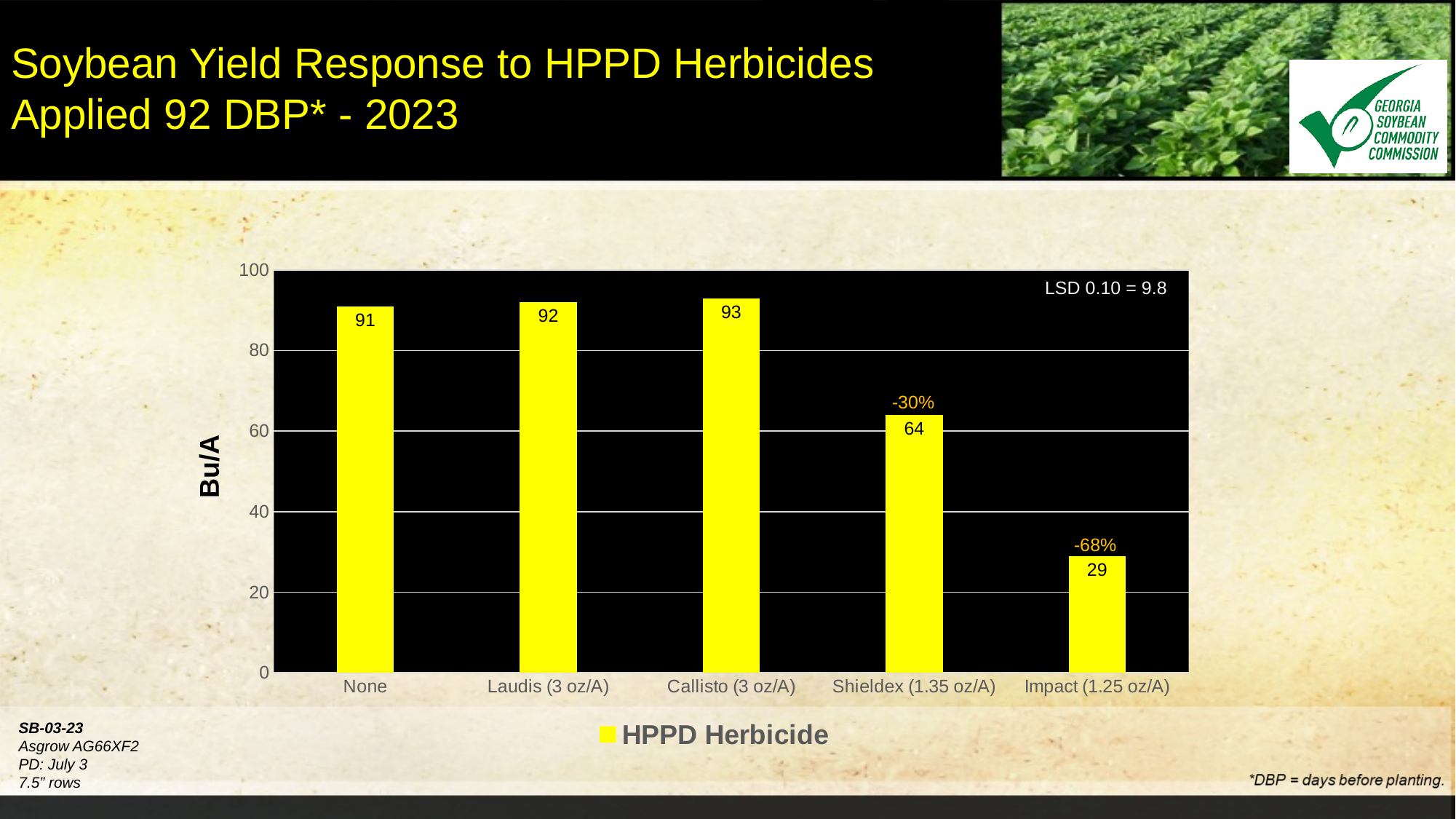
What percentage change is labeled above the Impact (1.25 oz/A) bar? -68% Which treatment has the highest yield? Callisto (3 oz/A) What is the yield in Bu/A for Impact (1.25 oz/A)? 29 What is the yield in Bu/A for Shieldex (1.35 oz/A)? 64 Which has a larger yield, Laudis (3 oz/A) or Shieldex (1.35 oz/A)? Laudis (3 oz/A) What is the yield in Bu/A for the None treatment? 91 How many treatments are shown on the x axis? 5 What is the difference in yield between Callisto (3 oz/A) and Shieldex (1.35 oz/A)? 29 What kind of chart is shown on the slide? Bar chart Is the yield for Shieldex (1.35 oz/A) greater or less than 60? greater Which treatment has the lowest yield? Impact (1.25 oz/A) What is the difference in yield between None and Impact (1.25 oz/A)? 62